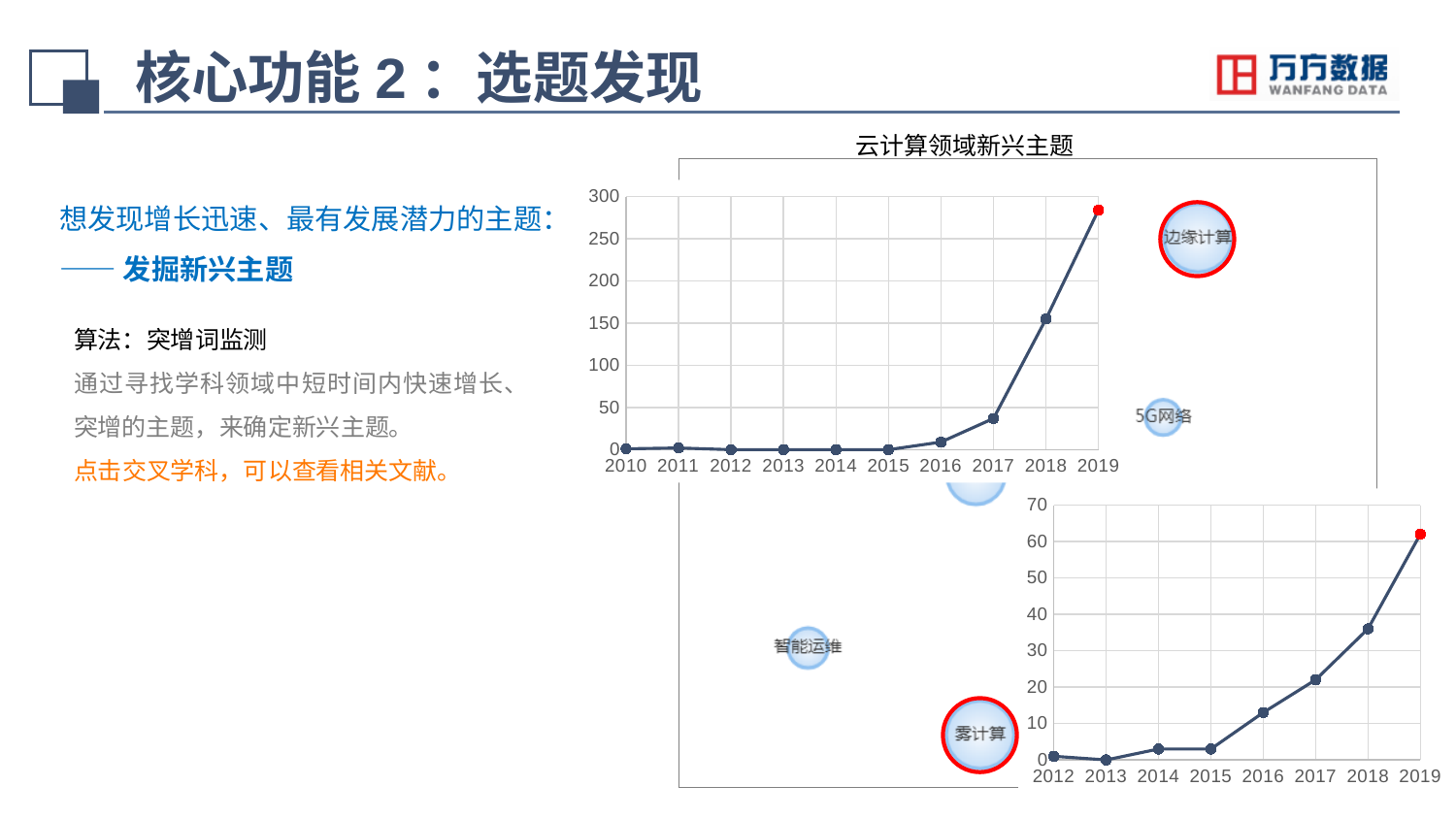
How many data points are plotted in the upper line chart (x axis 2010 to 2019)? 10 In the lower-right line chart (x axis 2012 to 2019), is the value for 2019 greater or less than 50? greater What kind of chart is the upper line chart on the slide (x axis 2010 to 2019)? line chart In the lower-right line chart (x axis 2012 to 2019), which year has the highest value? 2019 In the lower-right line chart (x axis 2012 to 2019), do the values generally rise or fall from 2015 to 2019? rise In the upper line chart (x axis 2010 to 2019), is the value for 2019 greater or less than 250? greater In the upper line chart (x axis 2010 to 2019), is the value for 2017 greater or less than 50? less In the upper line chart (x axis 2010 to 2019), which year has the highest value? 2019 In the upper line chart (x axis 2010 to 2019), which is larger, the value for 2018 or the value for 2017? 2018 How many data points are plotted in the lower-right line chart (x axis 2012 to 2019)? 8 What is the title of the bubble chart on the slide? 云计算领域新兴主题